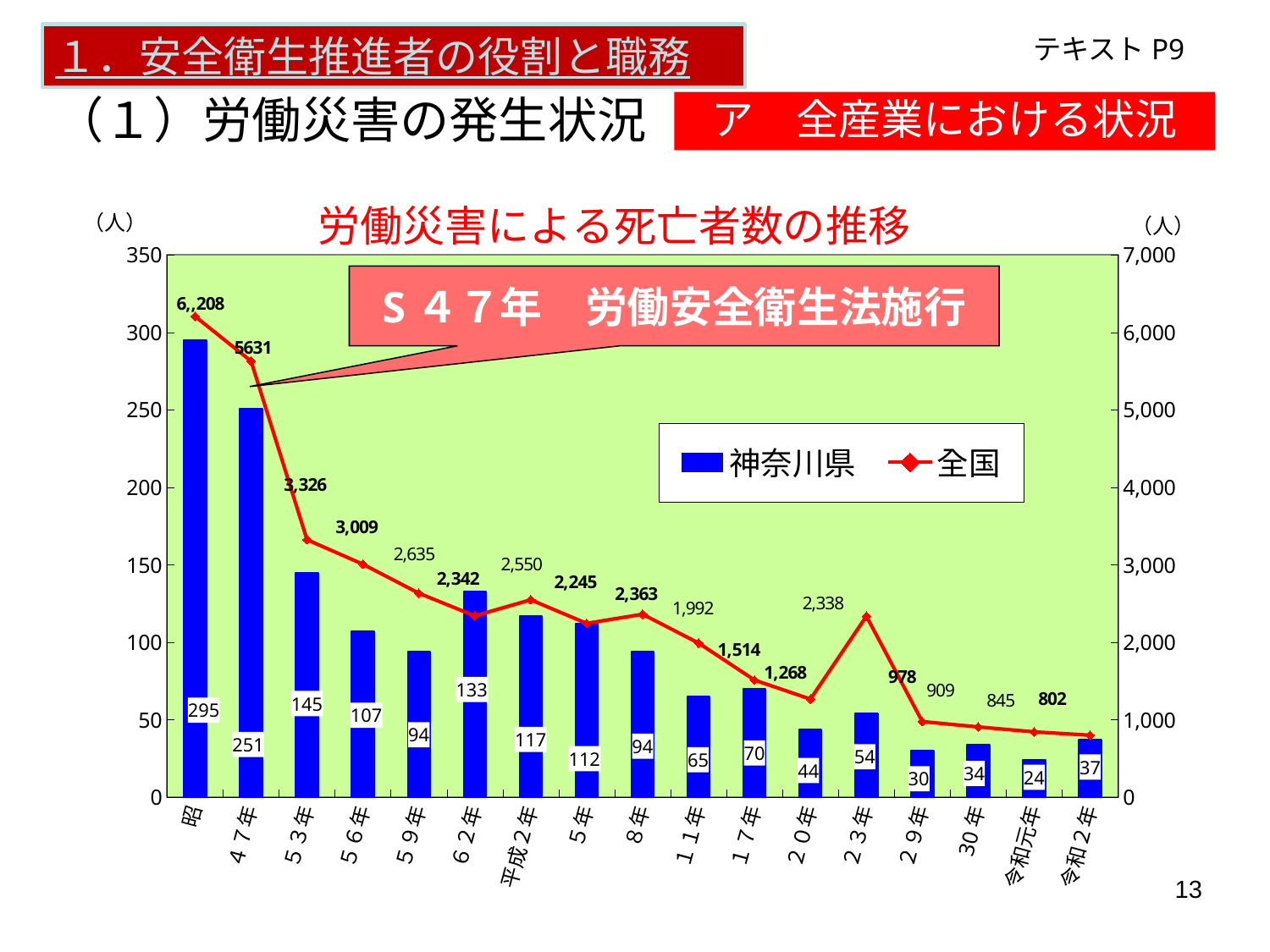
What is the difference between the 神奈川県 values for 昭 and 47年? 44 What is the value for 全国 in 17年? 1,514 What kind of chart is this? Combined bar and line chart What is the value for 神奈川県 in 53年? 145 How many categories are shown on the x axis? 17 Which category has the highest value for 全国? 昭 What is the title of the chart? 労働災害による死亡者数の推移 What is the value for 全国 in 23年? 2,338 What is the value for 神奈川県 in 令和2年? 37 How many series does the legend list? 2 Which is larger for 全国: 62年 or 平成2年? 平成2年 Which category has the lowest value for 神奈川県? 令和元年